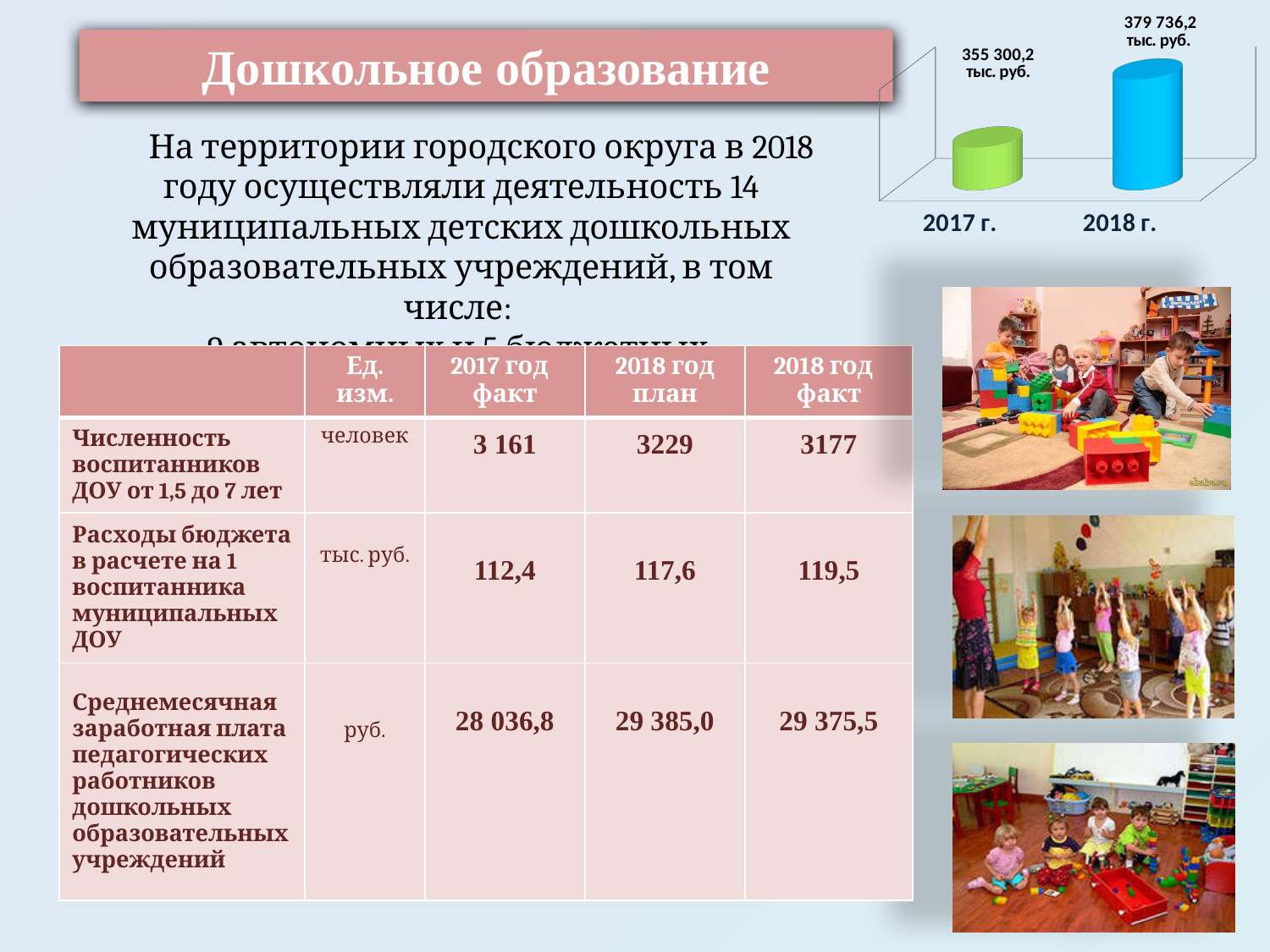
By how much does the 2018 г. value exceed the 2017 г. value in the chart? 24 436,0 тыс. руб. What colour is the bar for 2018 г. in the chart? blue Which year has the lower value in the chart? 2017 г. What kind of chart is shown in the top right of the slide? bar chart How many categories (years) are plotted in the chart? 2 Which year has the higher value in the chart? 2018 г. What colour is the bar for 2017 г. in the chart? green Is the value for 2017 г. larger or smaller than the value for 2018 г. in the chart? smaller What value is shown for 2018 г. in the chart? 379 736,2 тыс. руб. Do the values in the chart rise or fall from 2017 г. to 2018 г.? rise What value is shown for 2017 г. in the chart? 355 300,2 тыс. руб.